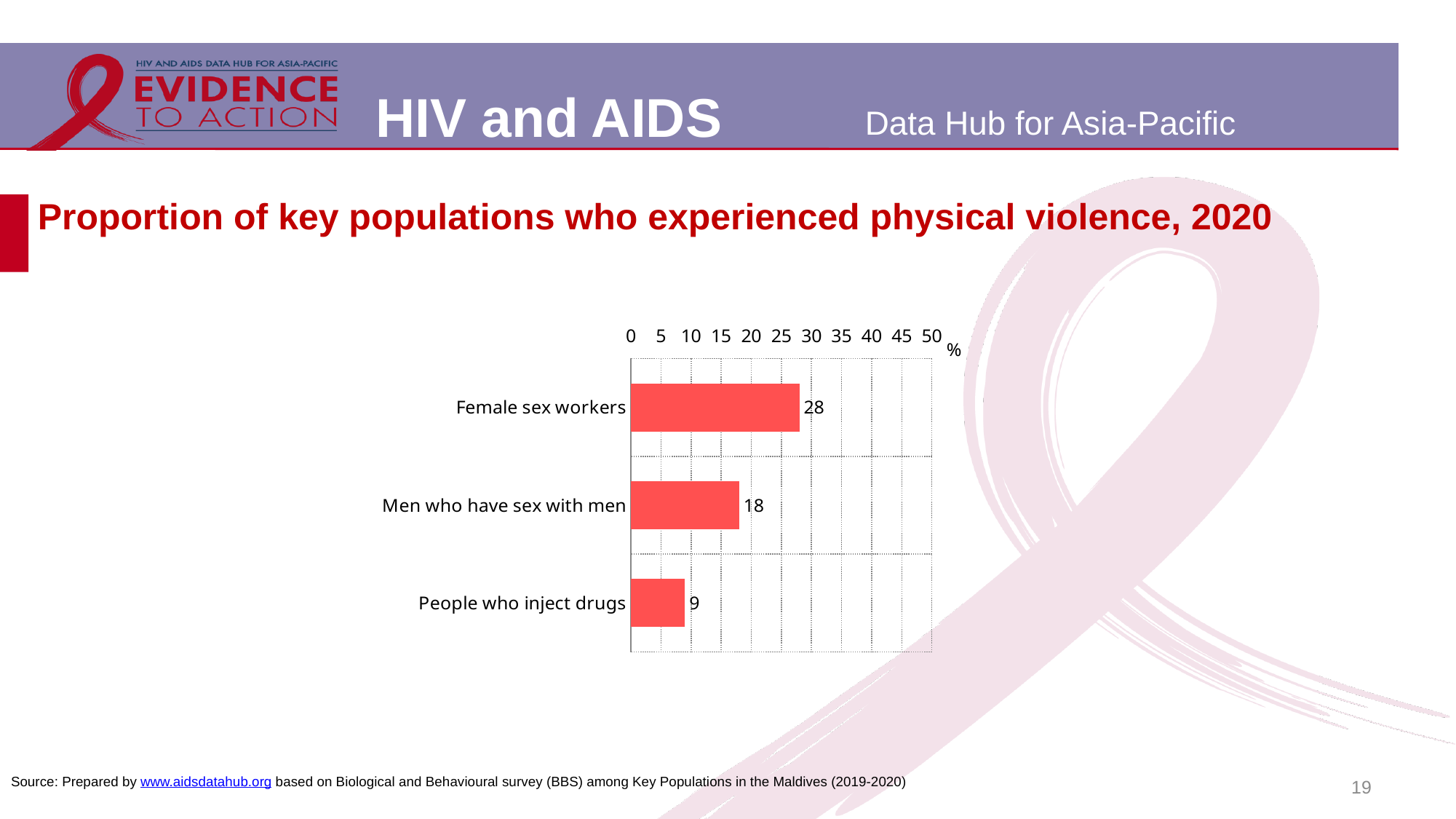
Is the value for Female sex workers greater or less than 25? greater What is the value for People who inject drugs? 9 What unit is shown on the axis of the chart? % What is the value for Female sex workers? 28 What kind of chart is shown on the slide? Bar chart What is the value for Men who have sex with men? 18 What is the difference between the values for Female sex workers and Men who have sex with men? 10 Which key population has the highest proportion who experienced physical violence? Female sex workers Which is larger, the value for Men who have sex with men or the value for People who inject drugs? Men who have sex with men How many key populations are shown in the chart? 3 Which key population has the lowest proportion who experienced physical violence? People who inject drugs What is the difference between the values for Men who have sex with men and People who inject drugs? 9